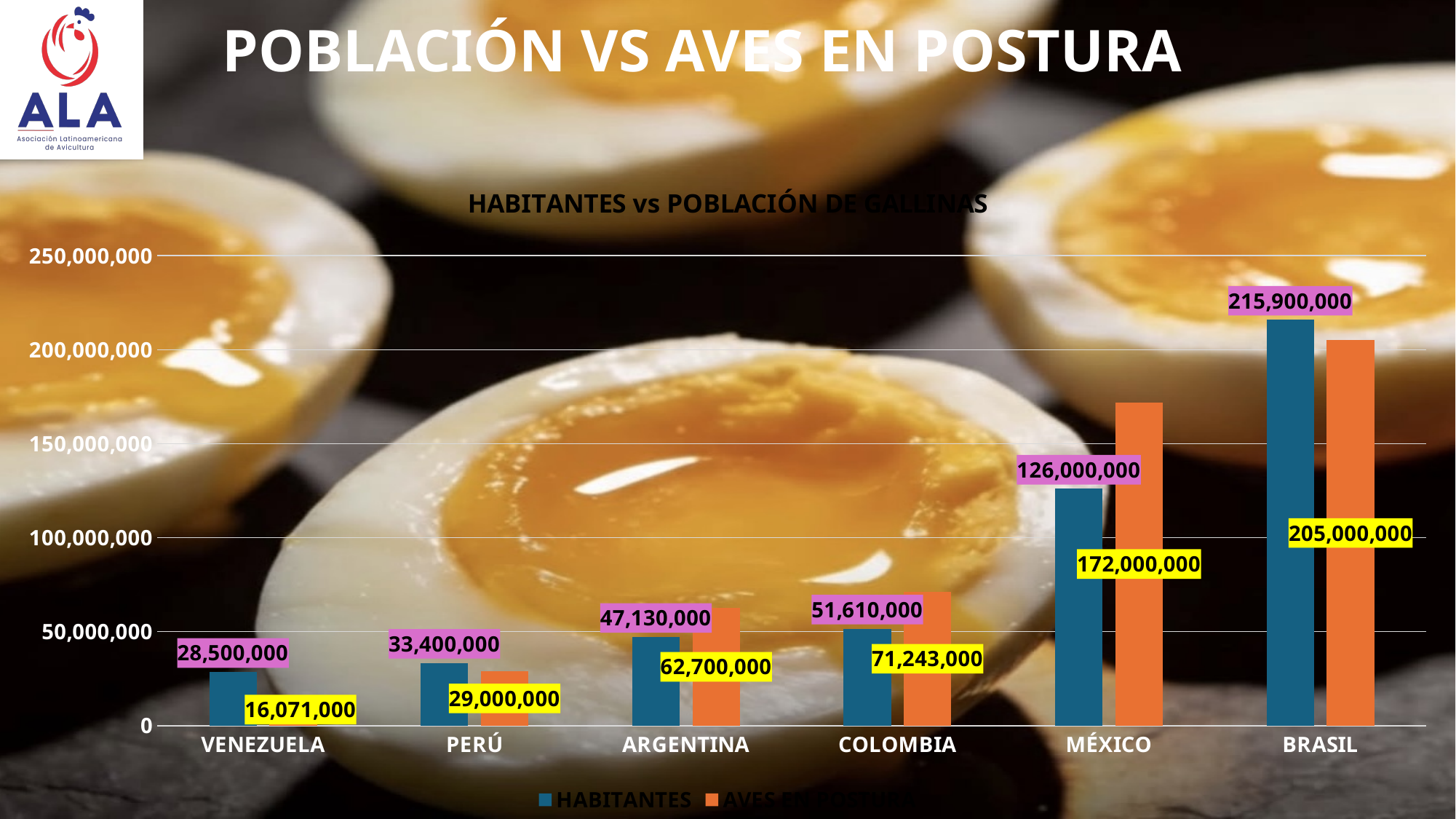
Which country has the lowest AVES EN POSTURA value? VENEZUELA For ARGENTINA, which is larger: HABITANTES or AVES EN POSTURA? AVES EN POSTURA What is the difference between the AVES EN POSTURA values for MÉXICO and COLOMBIA? 100,757,000 What is the HABITANTES value for MÉXICO? 126,000,000 Which country has the highest HABITANTES value? BRASIL What type of chart is shown on the slide? bar chart What is the AVES EN POSTURA value for COLOMBIA? 71,243,000 Is the AVES EN POSTURA value for MÉXICO greater or less than 150,000,000? greater What is the AVES EN POSTURA value for VENEZUELA? 16,071,000 How many countries are shown on the x axis? 6 What is the difference between the HABITANTES and AVES EN POSTURA values for BRASIL? 10,900,000 How many series does the legend list? 2